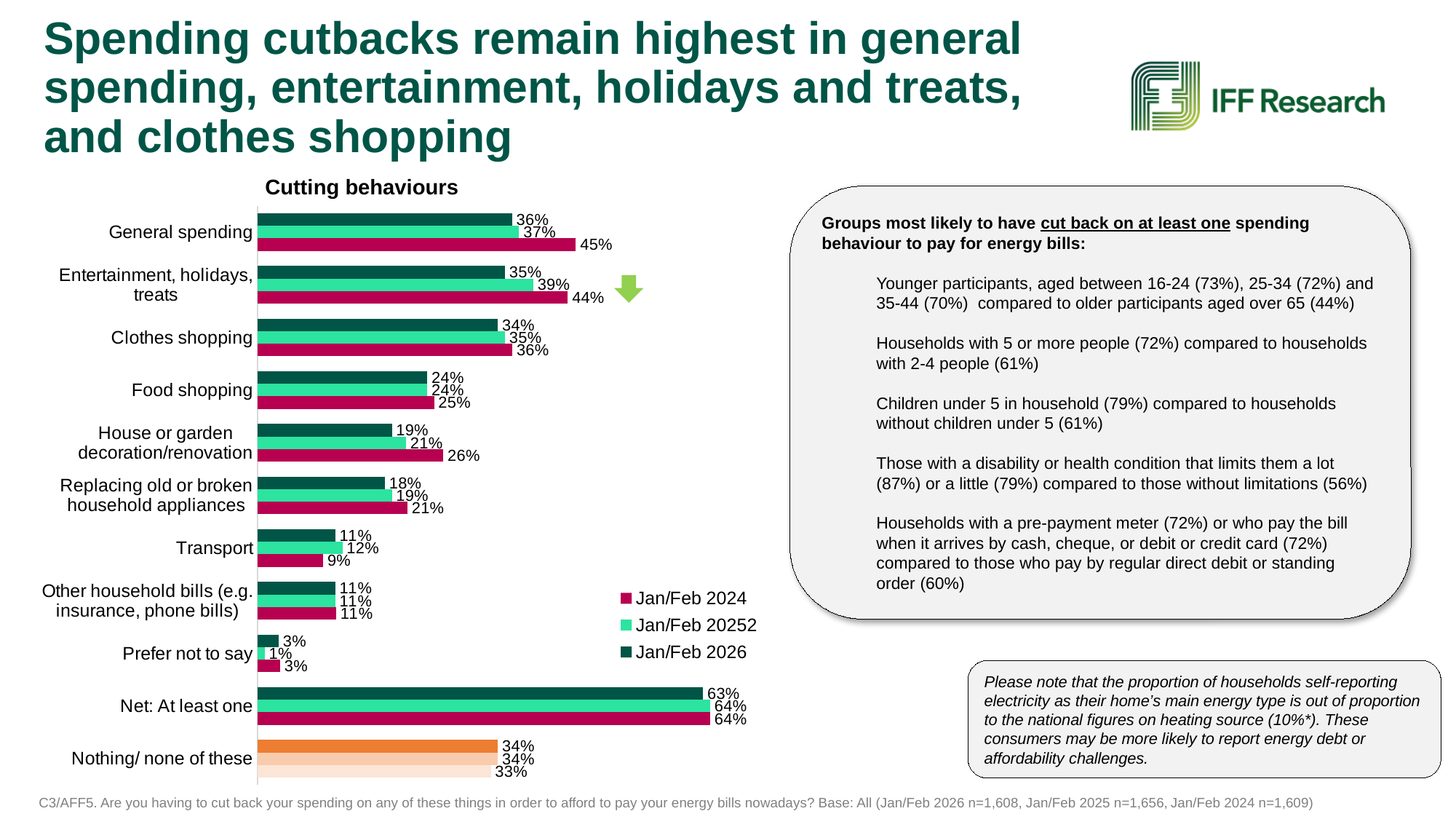
In the "Cutting behaviours" chart, what is the Jan/Feb 2024 value for Transport? 9% How many categories are shown on the y axis of the "Cutting behaviours" chart? 11 In the "Cutting behaviours" chart, which category has the lowest Jan/Feb 2026 value? Prefer not to say In the "Cutting behaviours" chart, what is the difference between the Jan/Feb 2024 and Jan/Feb 2026 values for General spending? 9 percentage points How many series does the legend of the "Cutting behaviours" chart list? 3 In the "Cutting behaviours" chart, which is larger for House or garden decoration/renovation: the Jan/Feb 2024 value or the Jan/Feb 2026 value? Jan/Feb 2024 In the "Cutting behaviours" chart, excluding the Net and Nothing rows, which category has the highest Jan/Feb 2024 value? General spending In the "Cutting behaviours" chart, what is the Jan/Feb 2026 value for Net: At least one? 63% In the "Cutting behaviours" chart, what colour are the Jan/Feb 2024 bars? Magenta/dark pink In the "Cutting behaviours" chart, what is the Jan/Feb 2026 value for Entertainment, holidays, treats? 35% In the "Cutting behaviours" chart, what is the Jan/Feb 2024 value for General spending? 45% What type of chart is shown under the title "Cutting behaviours"? Bar chart